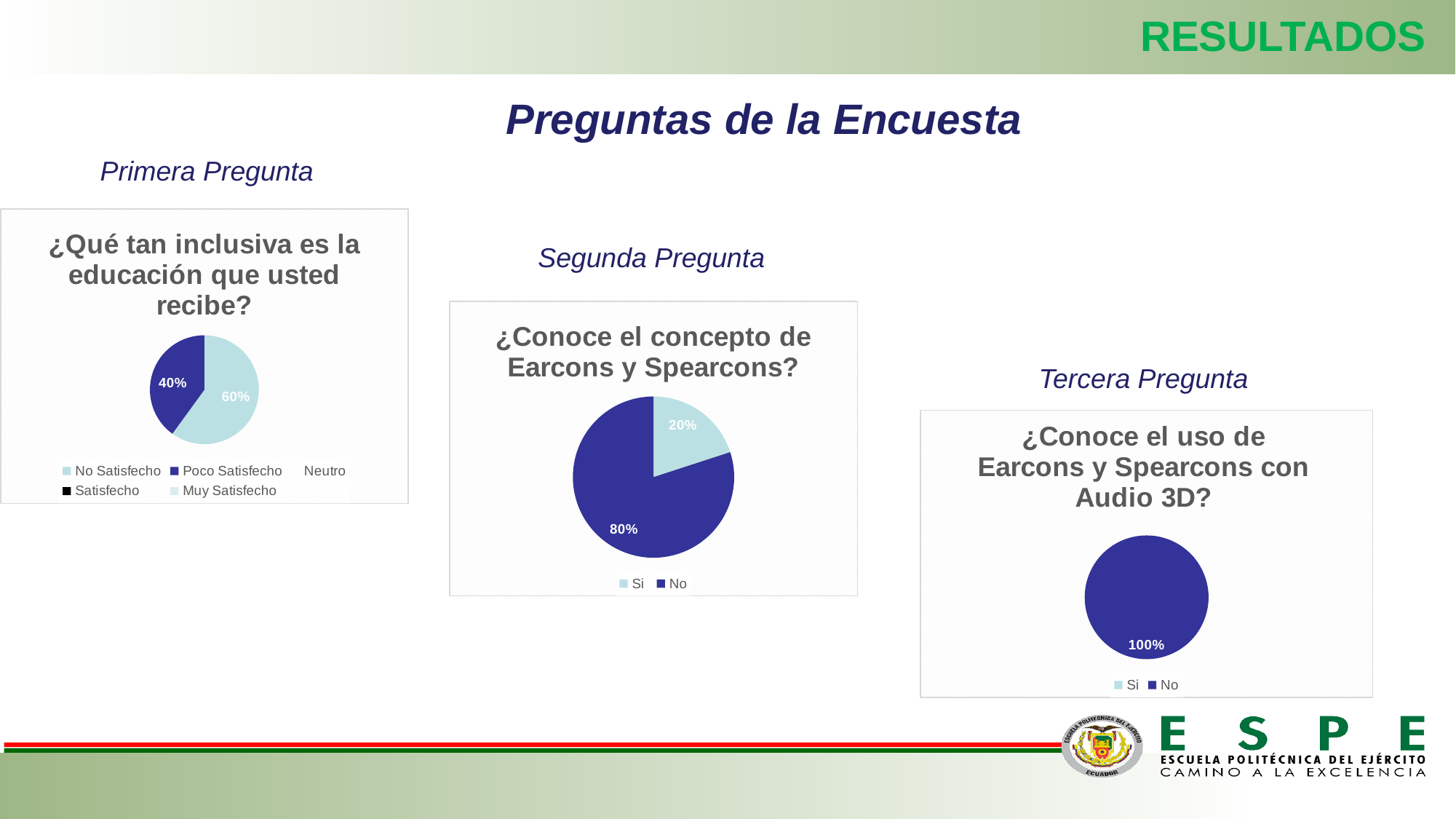
In the chart titled '¿Conoce el concepto de Earcons y Spearcons?', what is the difference between the 'No' and 'Si' shares? 60% In the chart titled '¿Qué tan inclusiva es la educación que usted recibe?', which slice is the largest? No Satisfecho In the chart titled '¿Conoce el uso de Earcons y Spearcons con Audio 3D?', what share does the 'No' slice have? 100% What kind of chart is used for the 'Tercera Pregunta' on the slide? Pie chart In the chart titled '¿Conoce el concepto de Earcons y Spearcons?', which is larger, 'Si' or 'No'? No In the chart titled '¿Qué tan inclusiva es la educación que usted recibe?', how many entries does the legend list? 5 How many charts are shown on the slide? 3 In the chart titled '¿Qué tan inclusiva es la educación que usted recibe?', what share does the 'No Satisfecho' slice have? 60% In the chart titled '¿Conoce el concepto de Earcons y Spearcons?', what share does the 'No' slice have? 80% In the chart titled '¿Qué tan inclusiva es la educación que usted recibe?', what is the difference between the 'No Satisfecho' and 'Poco Satisfecho' shares? 20%